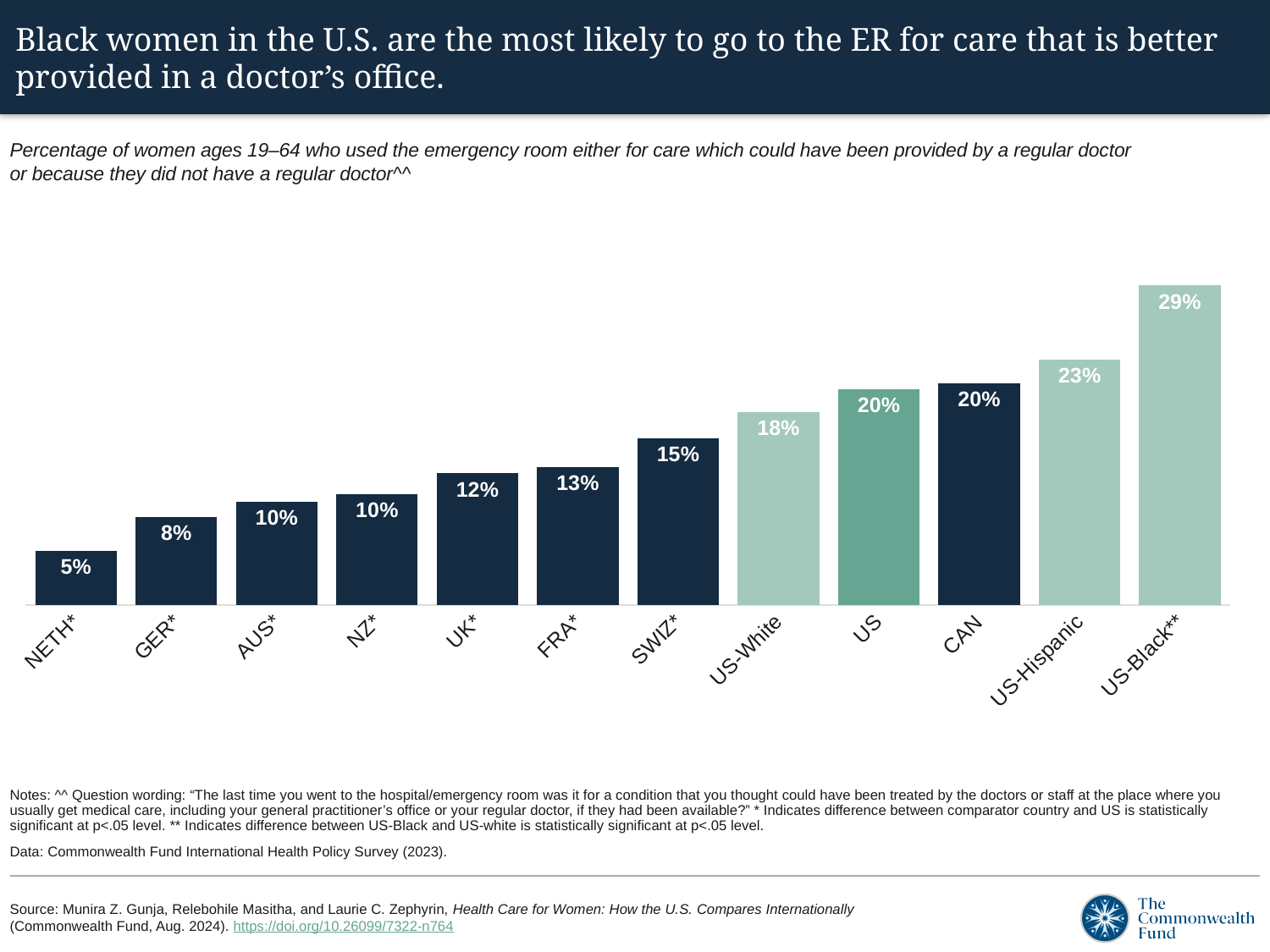
What is the difference between the values for US-Black** and US-White? 11% Which category has the lowest value? NETH* Which is larger, the value for FRA* or the value for UK*? FRA* What kind of chart is shown on the slide? Bar chart What is the value for SWIZ*? 15% What is the value for US-Black**? 29% Do the values rise or fall from left to right along the x axis? Rise What is the value for NETH*? 5% Which category has the highest value? US-Black** How many categories are shown on the x axis? 12 What is the difference between the values for US-Hispanic and GER*? 15% What is the value for US-White? 18%